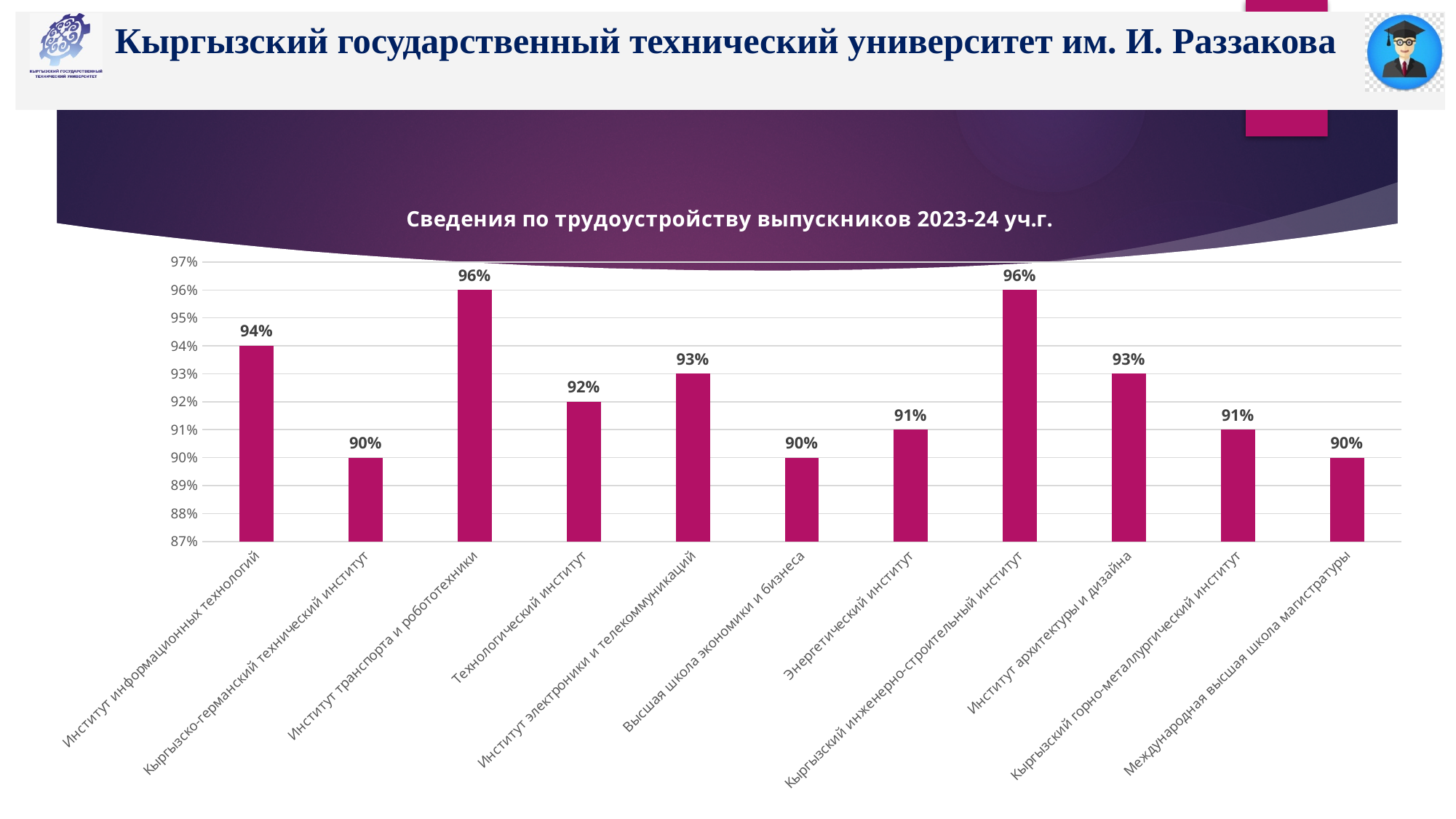
What value is shown for Технологический институт? 92% What is the employment rate shown for Институт информационных технологий? 94% What is the difference between the values for Институт транспорта и робототехники and Кыргызско-германский технический институт? 6% What value is shown for Международная высшая школа магистратуры? 90% What is the value for Институт архитектуры и дизайна? 93% Which has a higher value: Институт электроники и телекоммуникаций or Энергетический институт? Институт электроники и телекоммуникаций How many institutes (categories) are shown on the chart? 11 What type of chart is shown on the slide? Bar chart Which has a higher value: Кыргызский инженерно-строительный институт or Кыргызский горно-металлургический институт? Кыргызский инженерно-строительный институт What is the lowest value shown on the chart? 90% What is the title of the chart? Сведения по трудоустройству выпускников 2023-24 уч.г. What is the highest value shown on the chart? 96%